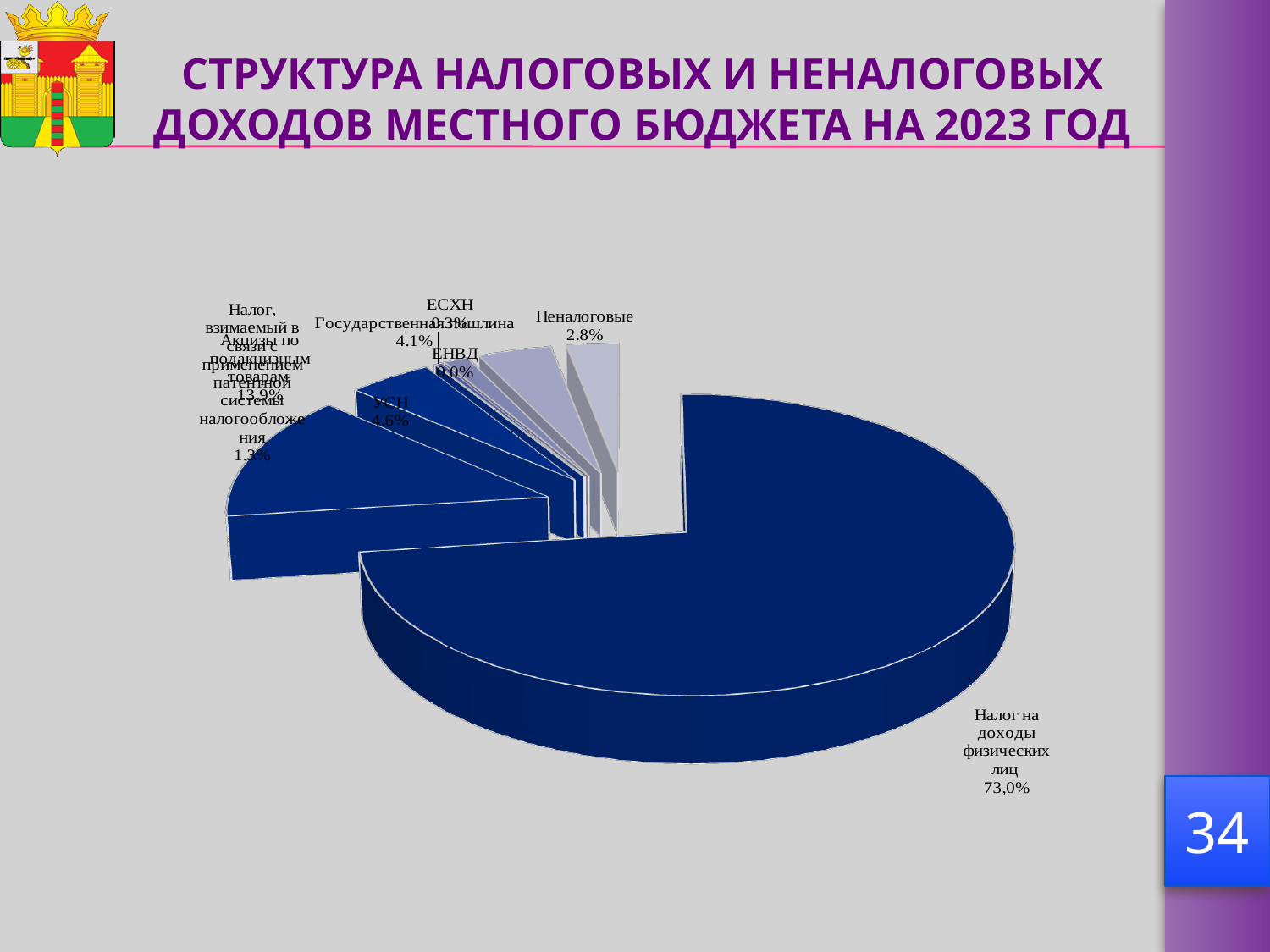
How many slices does the pie chart have? 8 What is the difference in percentage points between Налог на доходы физических лиц and Неналоговые? 70,2 What share is shown for ЕНВД? 0.0% What share is shown for УСН? 4.6% Which category has the largest share of the pie? Налог на доходы физических лиц What share is shown for Акцизы по подакцизным товарам? 13.9% Which category has the smallest share of the pie? ЕНВД Which is larger, the share for УСН or the share for Государственная пошлина? УСН What share of the pie is labelled for Налог на доходы физических лиц? 73,0% What share is shown for Неналоговые? 2.8% What share is shown for Государственная пошлина? 4.1% What kind of chart is shown on the slide? pie chart